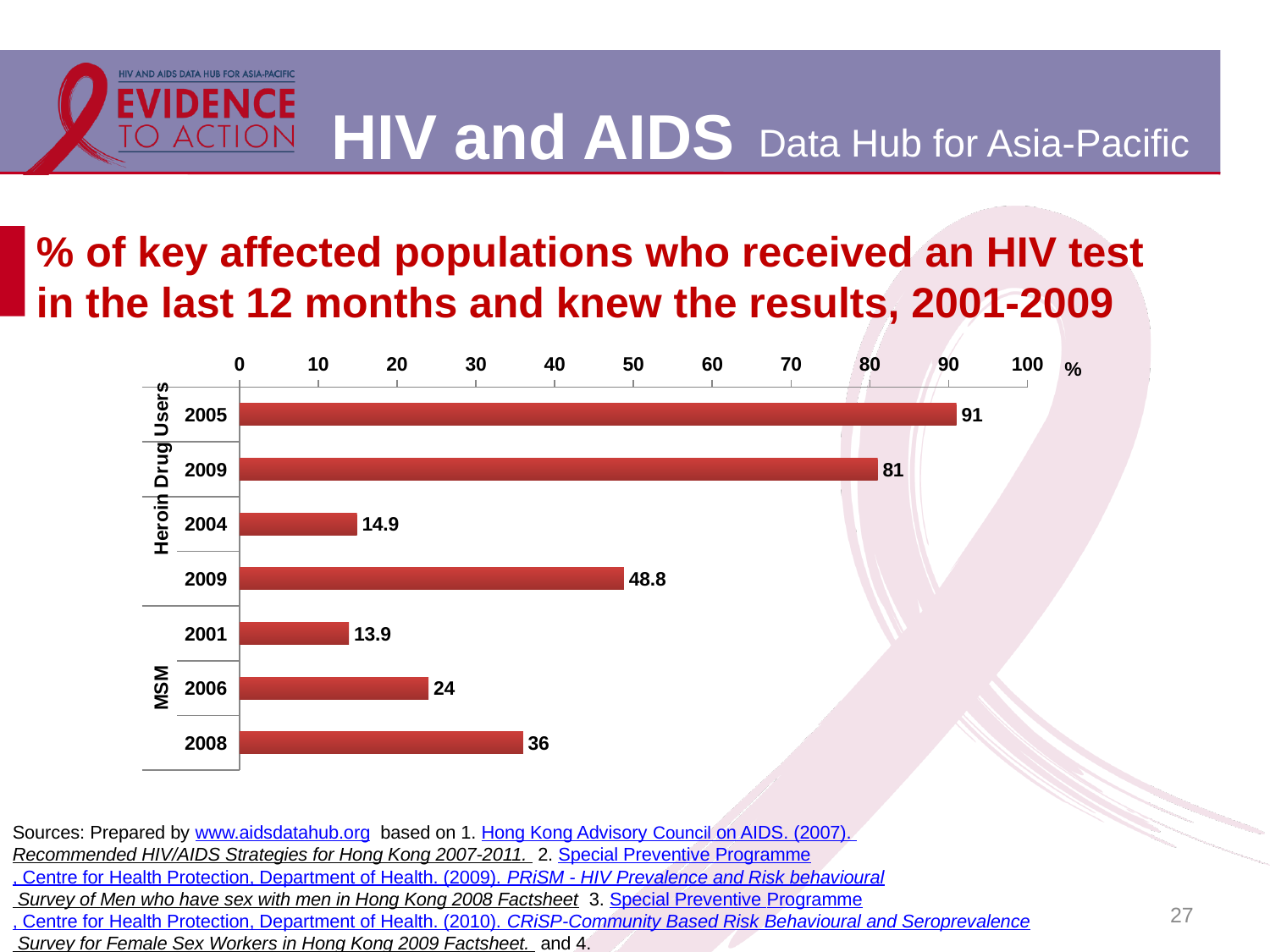
What is the value for Heroin Drug Users in 2009? 81 What type of chart is shown on the slide? bar chart What is the value for MSM in 2008? 36 What is the value for the 2004 bar in the middle group of the chart? 14.9 What is the value for Heroin Drug Users in 2005? 91 Which bar has the lowest value in the chart? MSM 2001 What is the value for MSM in 2006? 24 What is the value for MSM in 2001? 13.9 What is the difference between the MSM values for 2008 and 2001? 22.1 Do the MSM values rise or fall from 2001 to 2008? rise What is the difference between the Heroin Drug Users values for 2005 and 2009? 10 Which bar has the highest value in the chart? Heroin Drug Users 2005